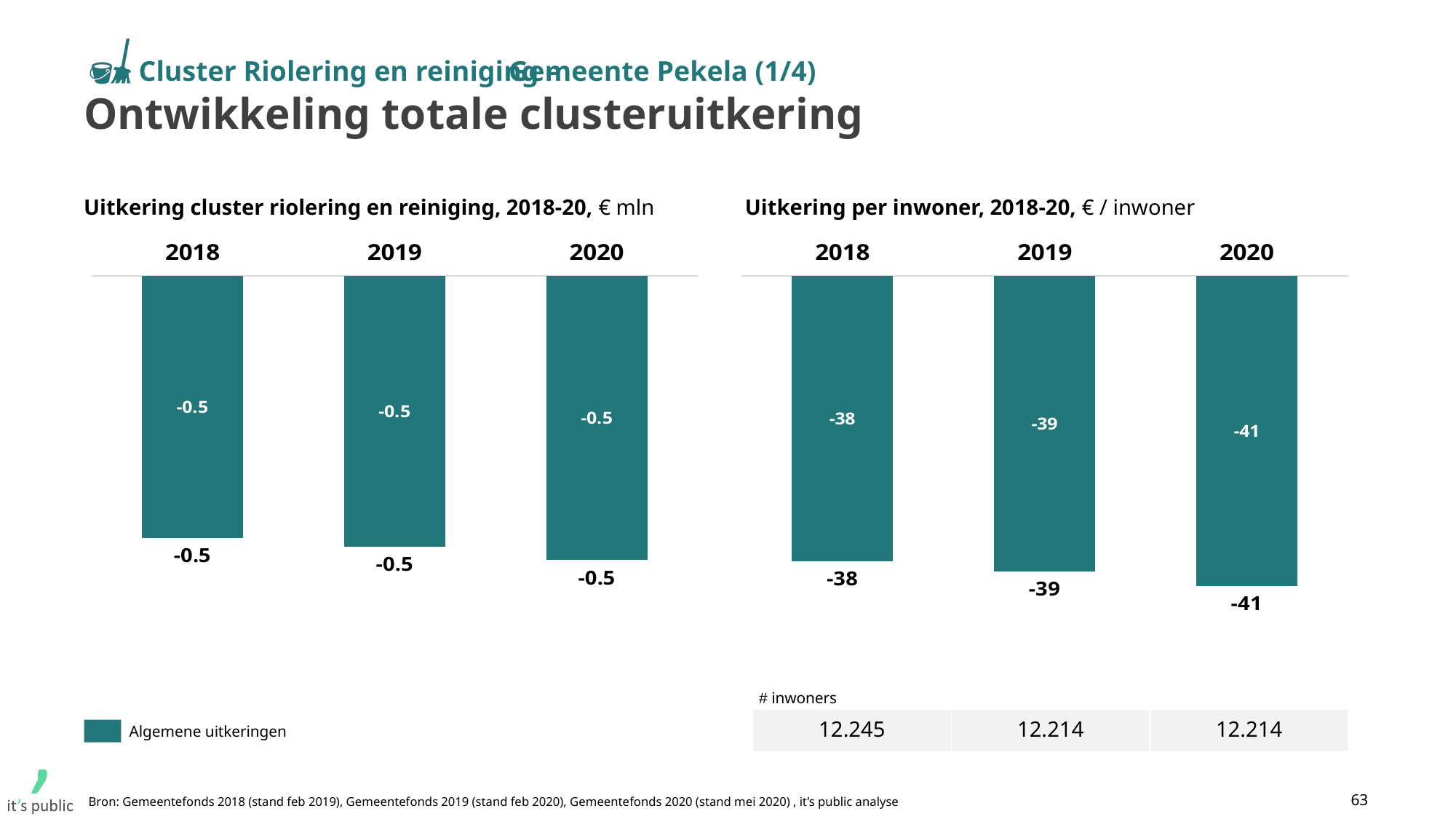
In the chart 'Uitkering per inwoner, 2018-20', is the value for 2019 larger or smaller than the value for 2020? larger What kind of chart is 'Uitkering per inwoner, 2018-20'? bar chart How many years are shown in the chart 'Uitkering cluster riolering en reiniging, 2018-20'? 3 In the chart 'Uitkering per inwoner, 2018-20', what is the value for 2018? -38 In the chart 'Uitkering per inwoner, 2018-20', what is the value for 2020? -41 In the chart 'Uitkering per inwoner, 2018-20', which year has the lowest (most negative) value? 2020 How many series does the legend on the slide list? 1 In the chart 'Uitkering per inwoner, 2018-20', which year has the highest (least negative) value? 2018 In the chart 'Uitkering cluster riolering en reiniging, 2018-20', what is the value for 2019? -0.5 In the chart 'Uitkering per inwoner, 2018-20', what is the difference between the 2018 value and the 2020 value? 3 In the chart 'Uitkering per inwoner, 2018-20', do the values rise or fall from 2018 to 2020? fall What is the legend entry shown below the left chart? Algemene uitkeringen